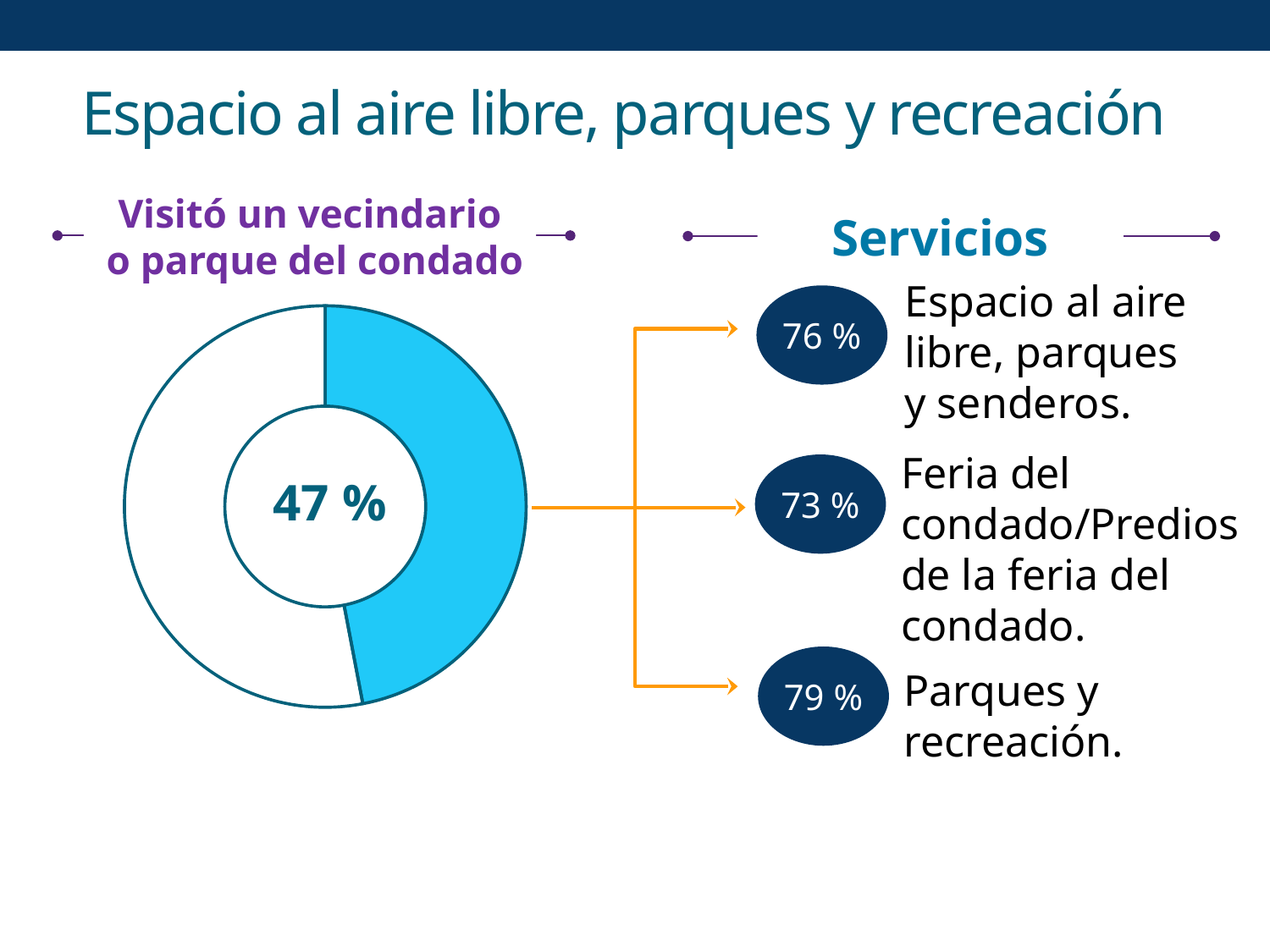
In the 'Servicios' section, what percentage is shown for 'Parques y recreación'? 79 % How many slices does the donut chart have? 2 What share of the donut chart does the highlighted (blue) slice represent? 47 % In the 'Servicios' section, which item has the lowest percentage? Feria del condado/Predios de la feria del condado What percentage is printed in the centre of the donut chart? 47 % What kind of chart is shown under the heading 'Visitó un vecindario o parque del condado'? Pie (donut) chart Is the highlighted slice of the donut chart greater or less than half of the whole? less What is the difference between the 'Parques y recreación' percentage (79 %) and the 'Feria del condado' percentage (73 %)? 6 % What is the title above the donut chart? Visitó un vecindario o parque del condado In the 'Servicios' section, which item has the highest percentage? Parques y recreación In the 'Servicios' section, what percentage is shown for 'Espacio al aire libre, parques y senderos'? 76 % What colour is the highlighted slice of the donut chart? Light blue